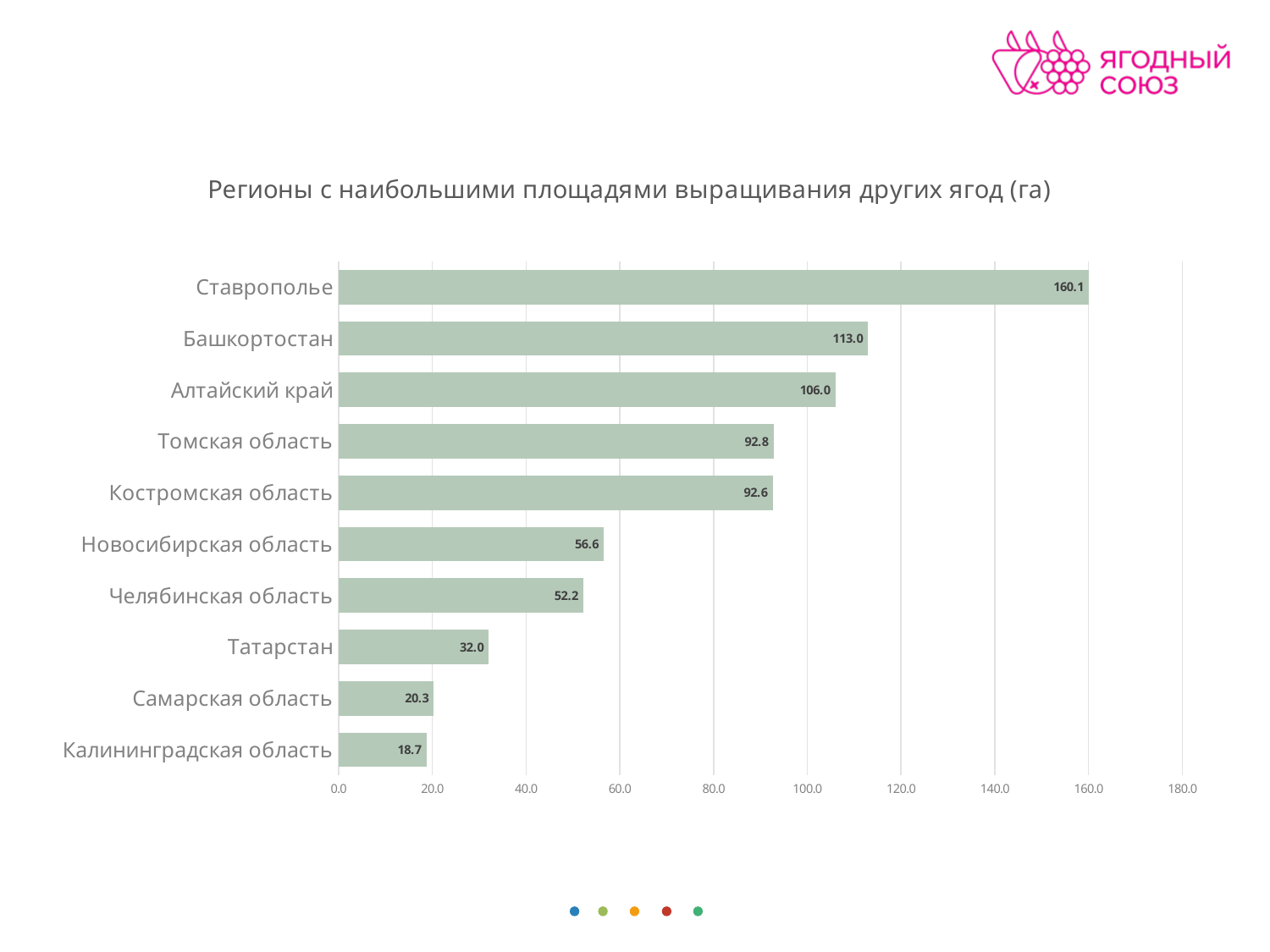
What is the difference between the values for Ставрополье and Татарстан? 128.1 What is the value for Ставрополье? 160.1 What is the title of the chart? Регионы с наибольшими площадями выращивания других ягод (га) Which region has the lowest value? Калининградская область Which region has the highest value? Ставрополье What is the value for Самарская область? 20.3 How many regions are shown in the chart? 10 What is the difference between the values for Башкортостан and Алтайский край? 7.0 Which is larger, the value for Новосибирская область or the value for Челябинская область? Новосибирская область What kind of chart is shown on the slide? bar chart Is the value for Башкортостан greater or less than 100.0? greater What is the value for Томская область? 92.8